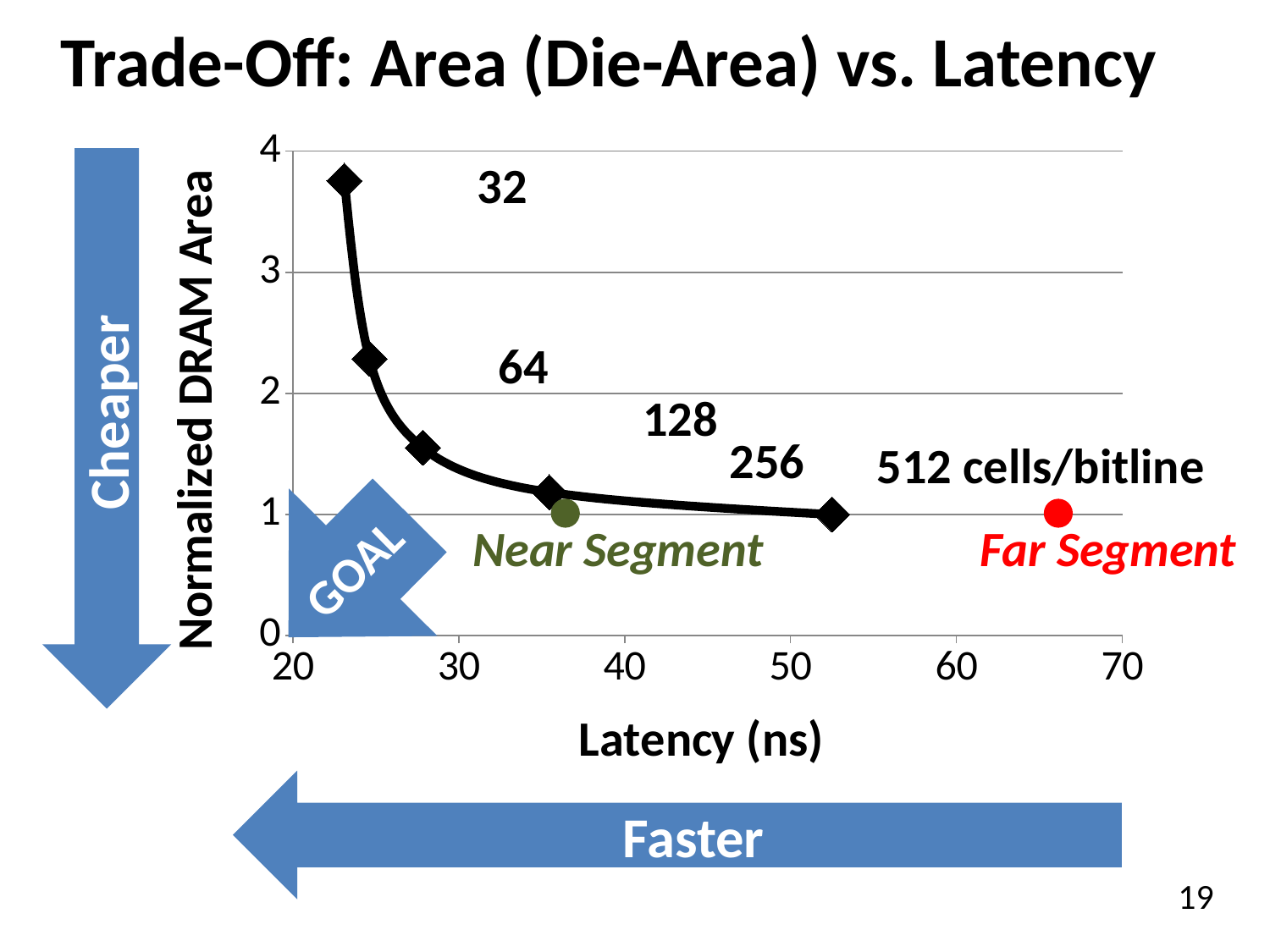
How many cells/bitline data points are plotted on the black curve? 5 Is the latency for 32 cells/bitline greater or less than 30 ns? less Is the Normalized DRAM Area for 64 cells/bitline greater or less than 2? greater Is the Normalized DRAM Area for 128 cells/bitline greater or less than 2? less Which cells/bitline configuration has the highest Normalized DRAM Area? 32 As latency increases along the x axis, does the Normalized DRAM Area rise or fall? fall Which has the larger Normalized DRAM Area, 64 cells/bitline or 128 cells/bitline? 64 cells/bitline Which cells/bitline configuration has the lowest Normalized DRAM Area? 512 What kind of chart is shown on the slide? line chart